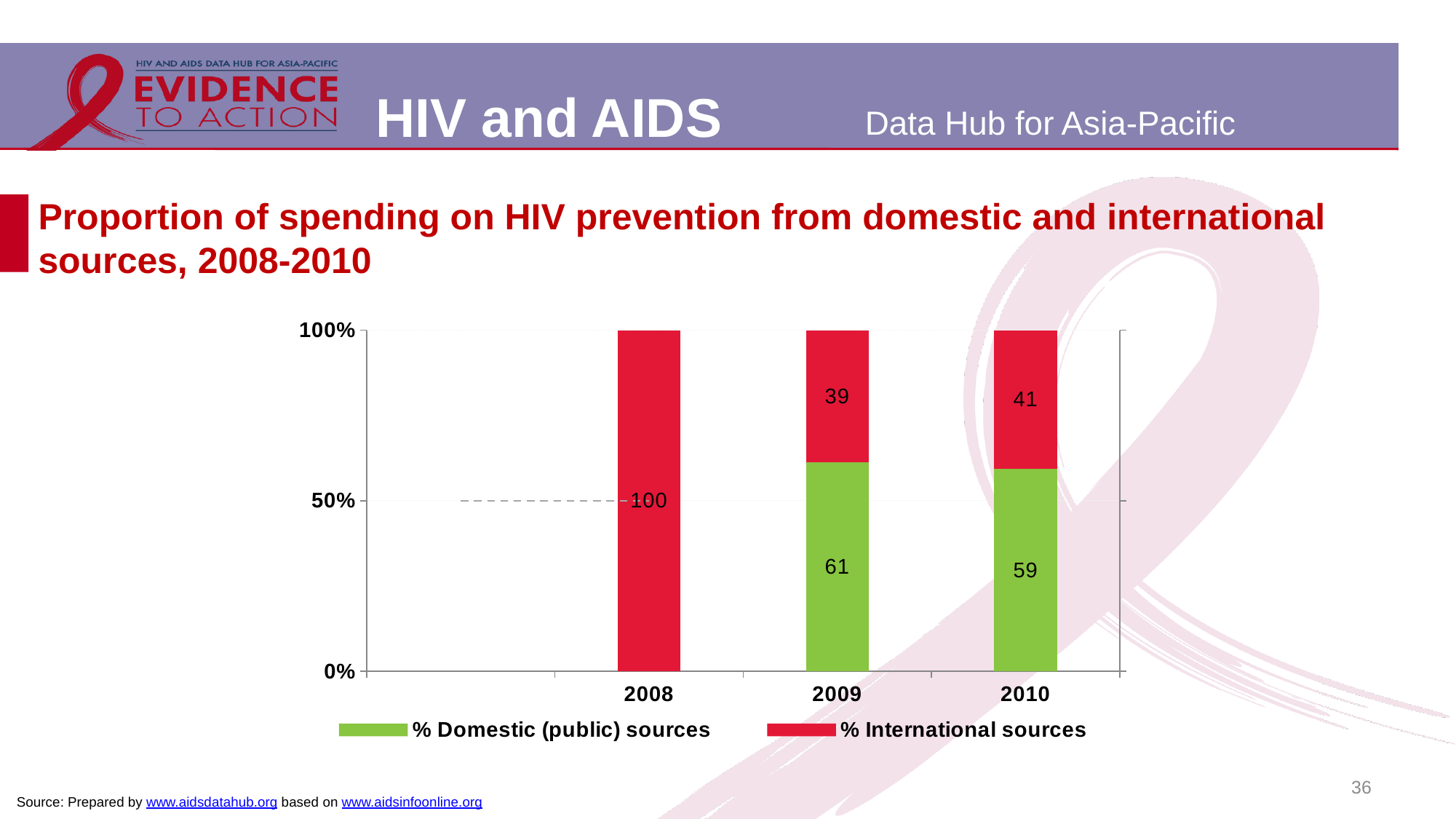
What is the value for % International sources in 2008? 100 What is the value for % International sources in 2010? 41 What is the difference between the % Domestic (public) sources values for 2009 and 2010? 2 Which colour represents % International sources in the chart? Red What is the value for % Domestic (public) sources in 2009? 61 Which is larger in 2009: % Domestic (public) sources or % International sources? % Domestic (public) sources What kind of chart is shown on the slide? Stacked bar chart What is the value for % Domestic (public) sources in 2010? 59 How many series does the legend list? 2 In which year is the % International sources value highest? 2008 How many years are shown on the x axis? 3 In which year is the % Domestic (public) sources value lowest? 2008